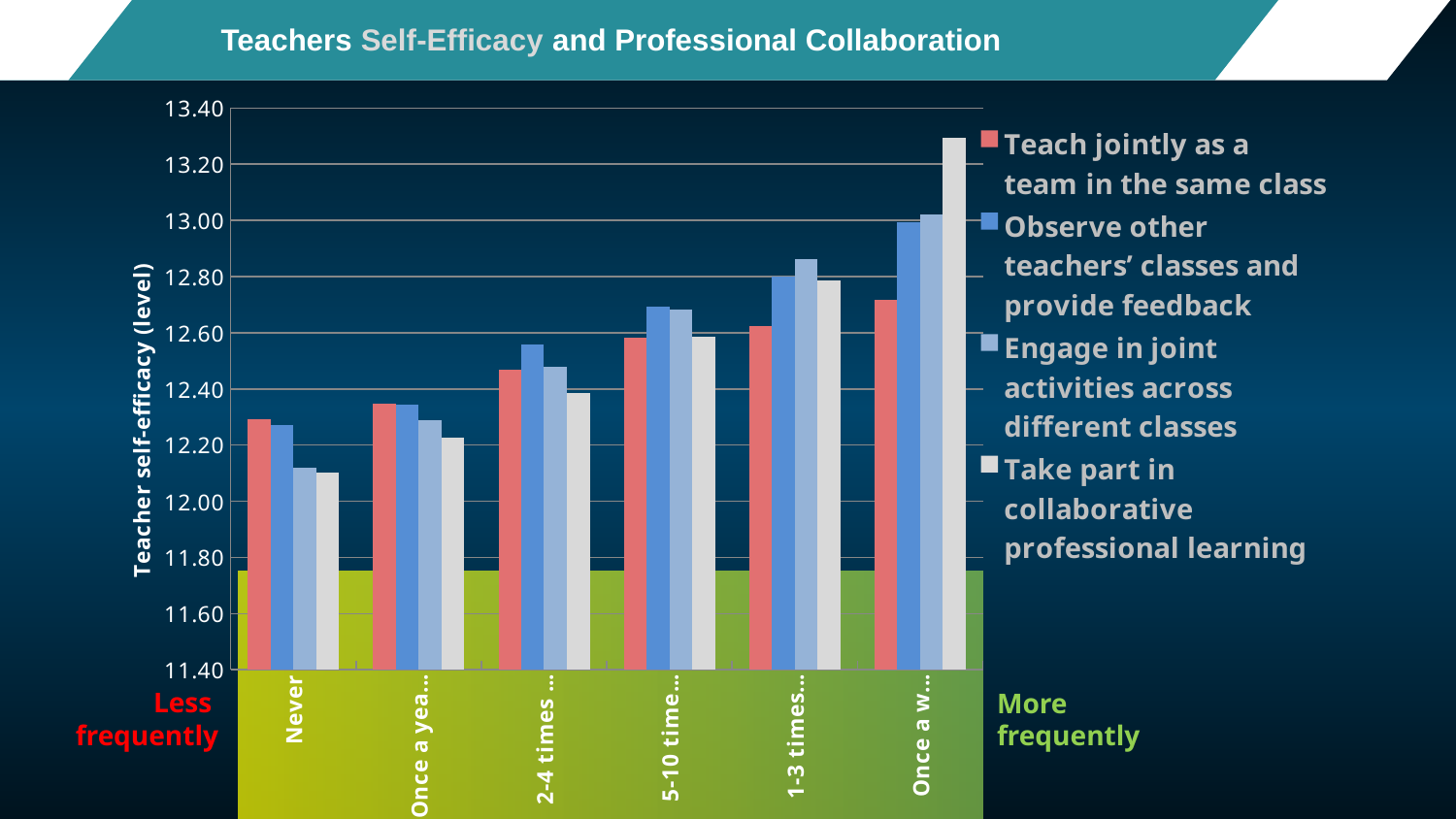
For 'Observe other teachers' classes and provide feedback', which category has the larger value: 'Never' or 'Once a w...'? Once a w... What is the label of the y axis? Teacher self-efficacy (level) For which category is the 'Teach jointly as a team in the same class' bar highest? Once a w... Is the value for 'Take part in collaborative professional learning' in the 'Never' category greater or less than 12.20? less Which series has the tallest bar in the rightmost category (Once a w...)? Take part in collaborative professional learning Is the value for 'Teach jointly as a team in the same class' in the 'Once a w...' category greater or less than 12.80? less How many frequency categories are shown along the x axis? 6 What kind of chart is shown on the slide? Bar chart Do the values for 'Teach jointly as a team in the same class' generally rise or fall from 'Never' to 'Once a w...'? Rise Is the value for 'Take part in collaborative professional learning' in the 'Once a w...' category greater or less than 13.20? greater How many series does the legend list? 4 Which legend entry is shown in red? Teach jointly as a team in the same class